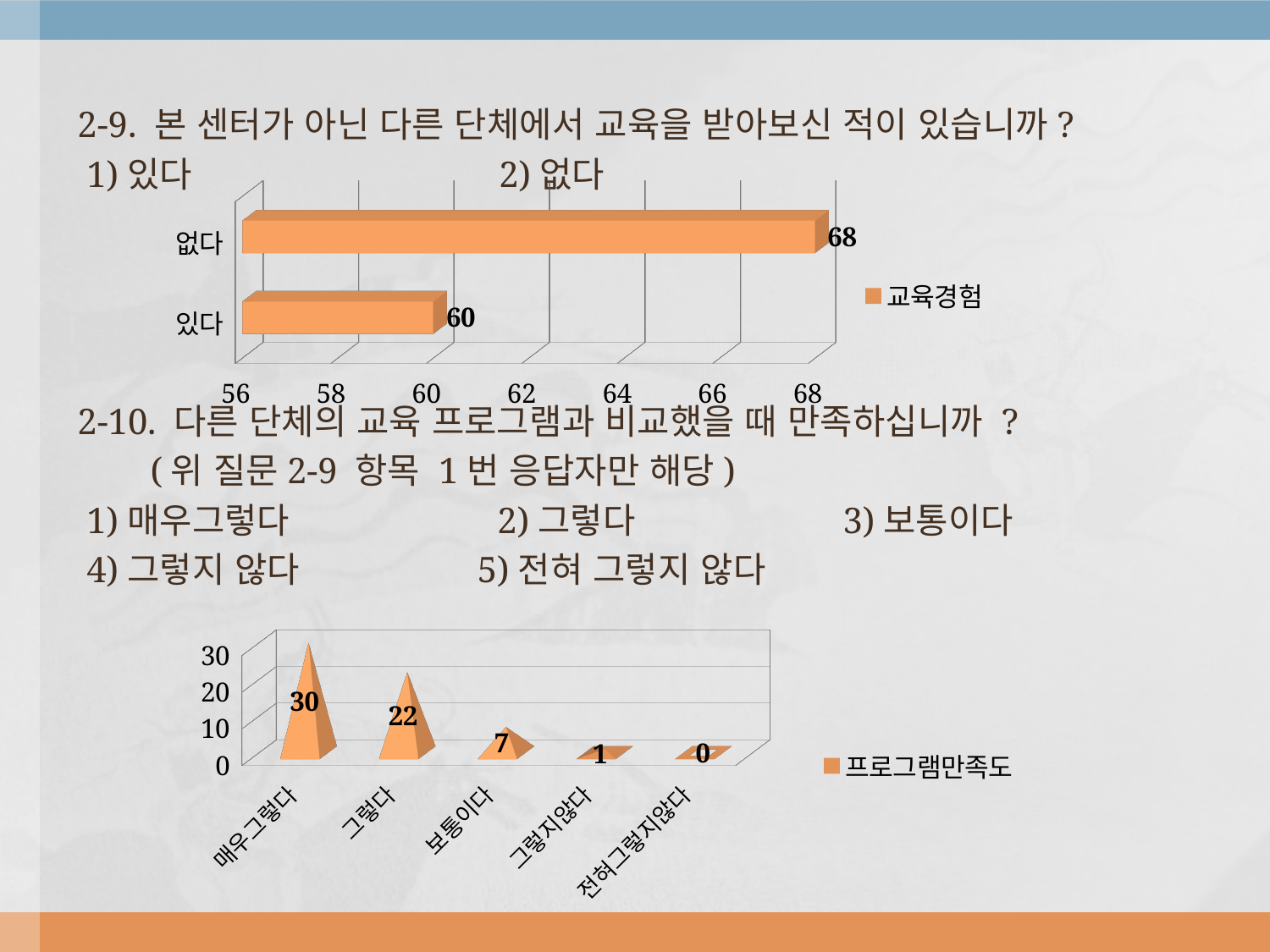
In the bottom chart, what is the difference between the values for 매우그렇다 and 그렇다? 8 In the bottom chart, which category has the lowest value? 전혀그렇지않다 In the bottom chart, do the values rise or fall from left to right along the x axis? fall In the bottom chart, what is the value for 보통이다? 7 In the bottom chart, what is the value for 매우그렇다? 30 In the top chart, how many categories are shown? 2 In the top chart, what series name does the legend show? 교육경험 In the top chart, which category has the higher value, 없다 or 있다? 없다 In the top chart, what is the value for 있다? 60 In the bottom chart, which category has the highest value? 매우그렇다 In the top chart, what is the value for 없다? 68 In the top chart, what is the difference between the values for 없다 and 있다? 8